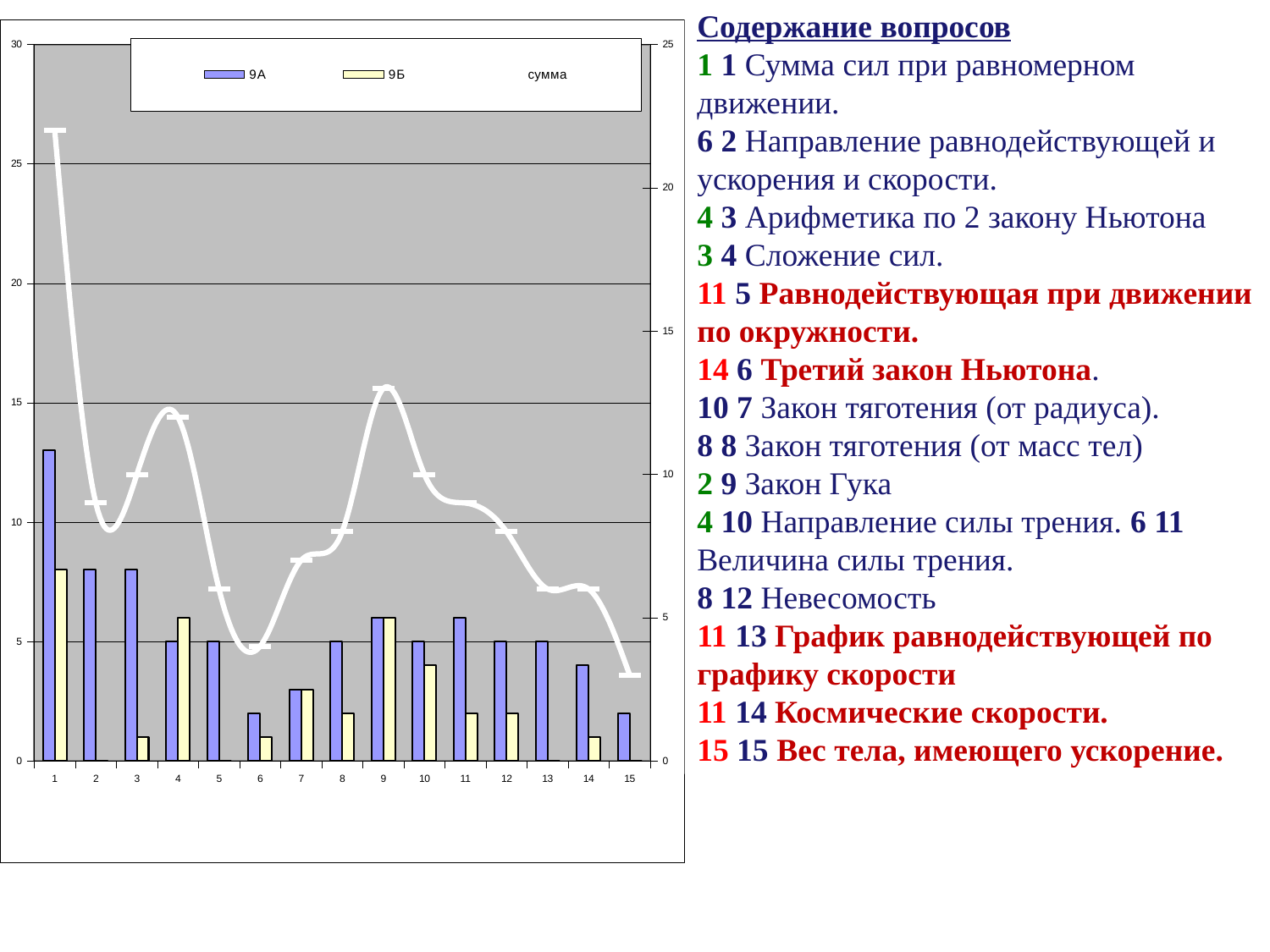
Which series is plotted as a line rather than bars? сумма Does the сумма line end higher or lower at category 15 than it starts at category 1? lower Is the value of 9А for category 2 greater or less than 10? less For which category is the 9А bar the highest? 1 What are the names of the two bar series in the legend? 9А and 9Б For which category is the 9Б bar the highest? 1 Is the value of 9А for category 1 greater or less than 10? greater How many categories are shown along the x axis? 15 How many series does the legend list? 3 What kind of chart is shown on the slide? A bar chart combined with a line Which is larger for category 1, the 9А bar or the 9Б bar? 9А Is the сумма value for category 1 greater or less than 20 on the right axis? greater